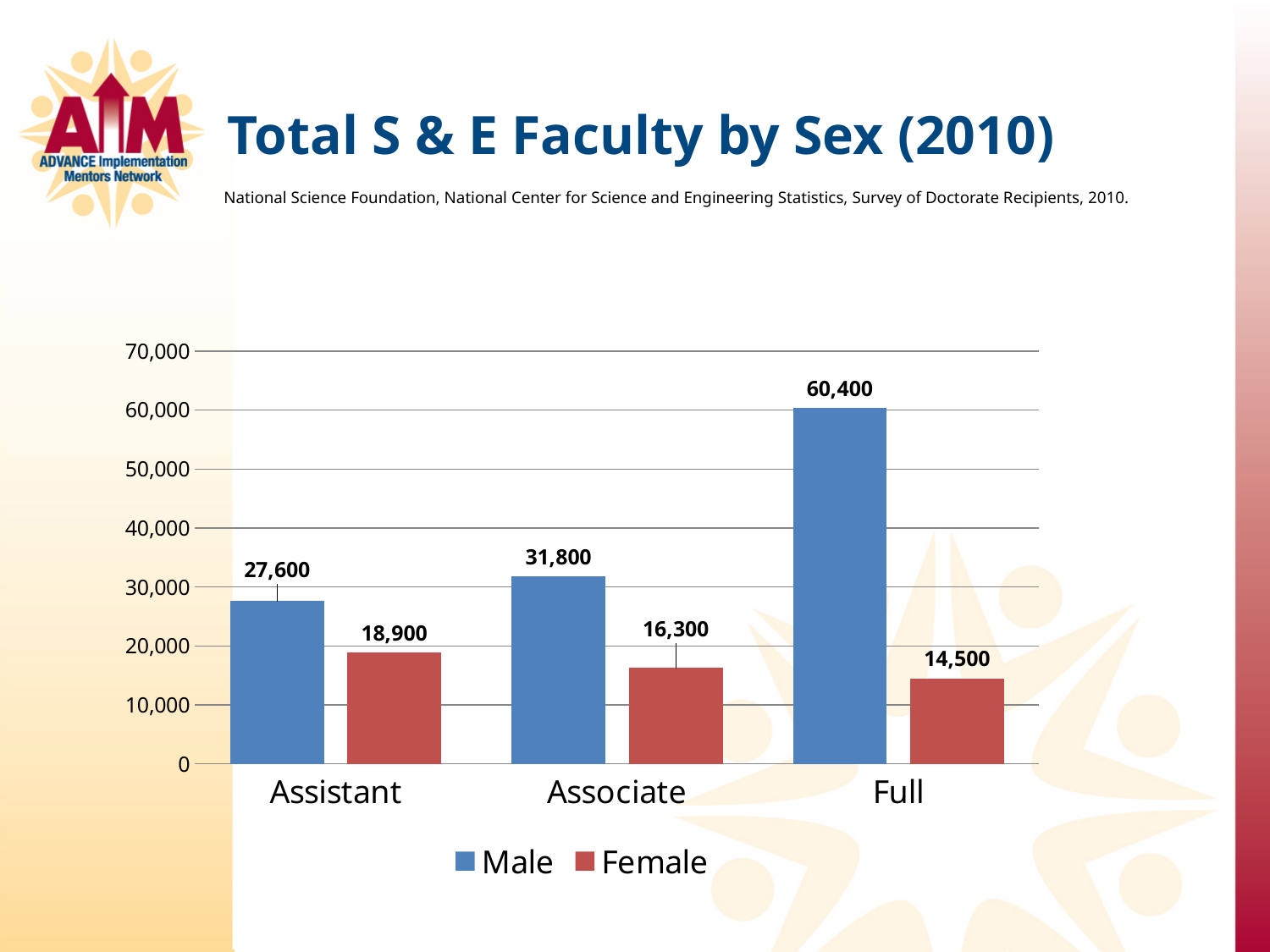
What is the value for Male faculty at the Full rank? 60,400 What is the value for Male faculty at the Associate rank? 31,800 Which rank has the lowest Female value? Full How many series does the legend list? 2 Which rank has the highest Male value? Full What is the value for Female faculty at the Full rank? 14,500 What is the difference between the Male values for Associate and Assistant? 4,200 What is the value for Female faculty at the Assistant rank? 18,900 What is the difference between the Male and Female values at the Full rank? 45,900 How many rank categories are shown on the x axis? 3 What kind of chart is shown on the slide? Bar chart Which is larger, the Female value for Assistant or the Female value for Associate? Assistant